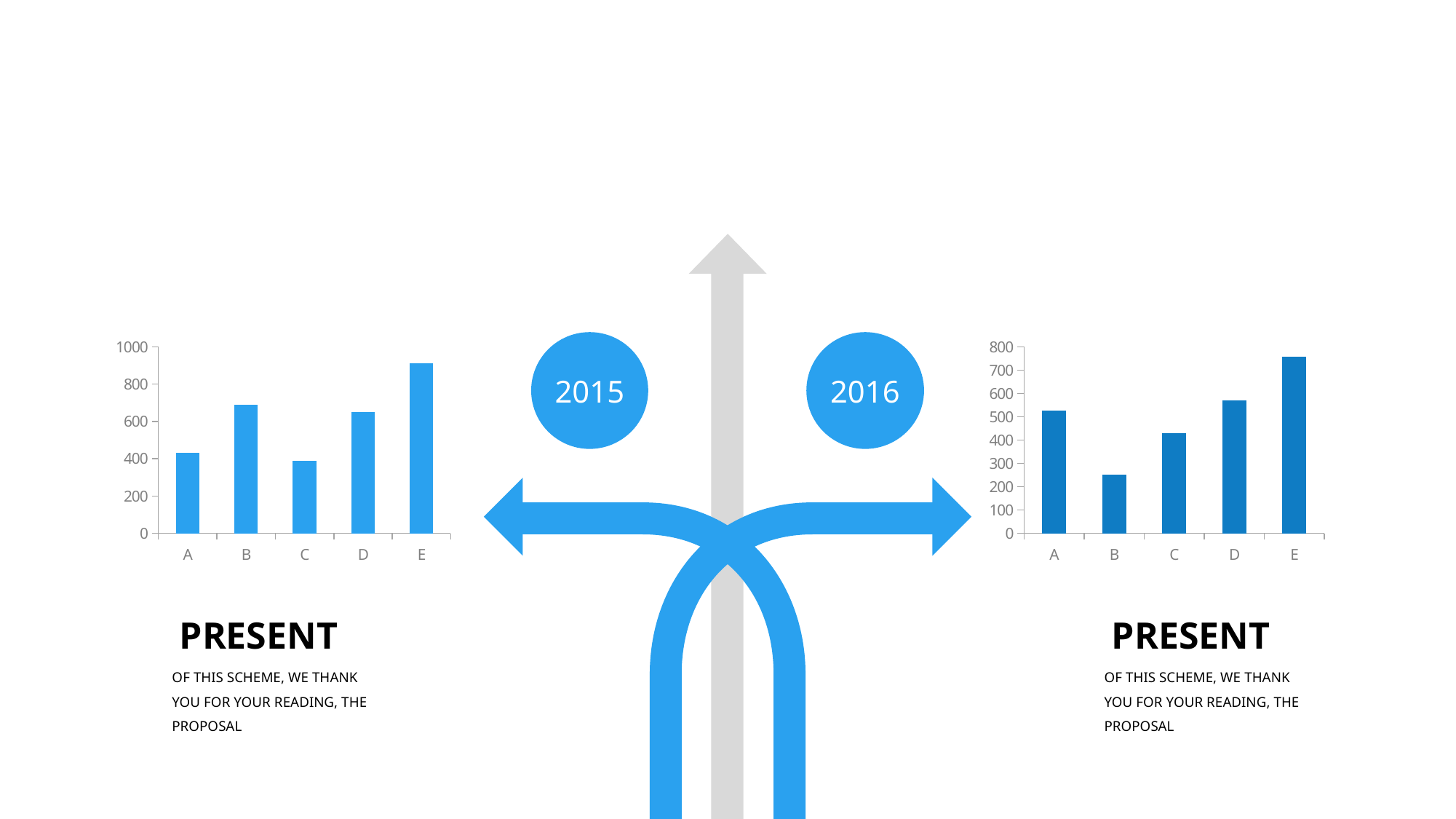
In the right chart, which category has the highest bar? E In the right chart, which is larger, the value for C or the value for D? D In the left chart, is the value for E greater or less than 800? greater In the left chart, which category has the lowest bar? C In the right chart, is the value for A greater or less than 500? greater In the left chart, which category has the highest bar? E How many categories does the left chart show? 5 In the left chart, which is larger, the value for B or the value for D? B How many categories does the right chart show? 5 In the right chart, which category has the lowest bar? B What kind of chart is the left chart on the slide? bar chart